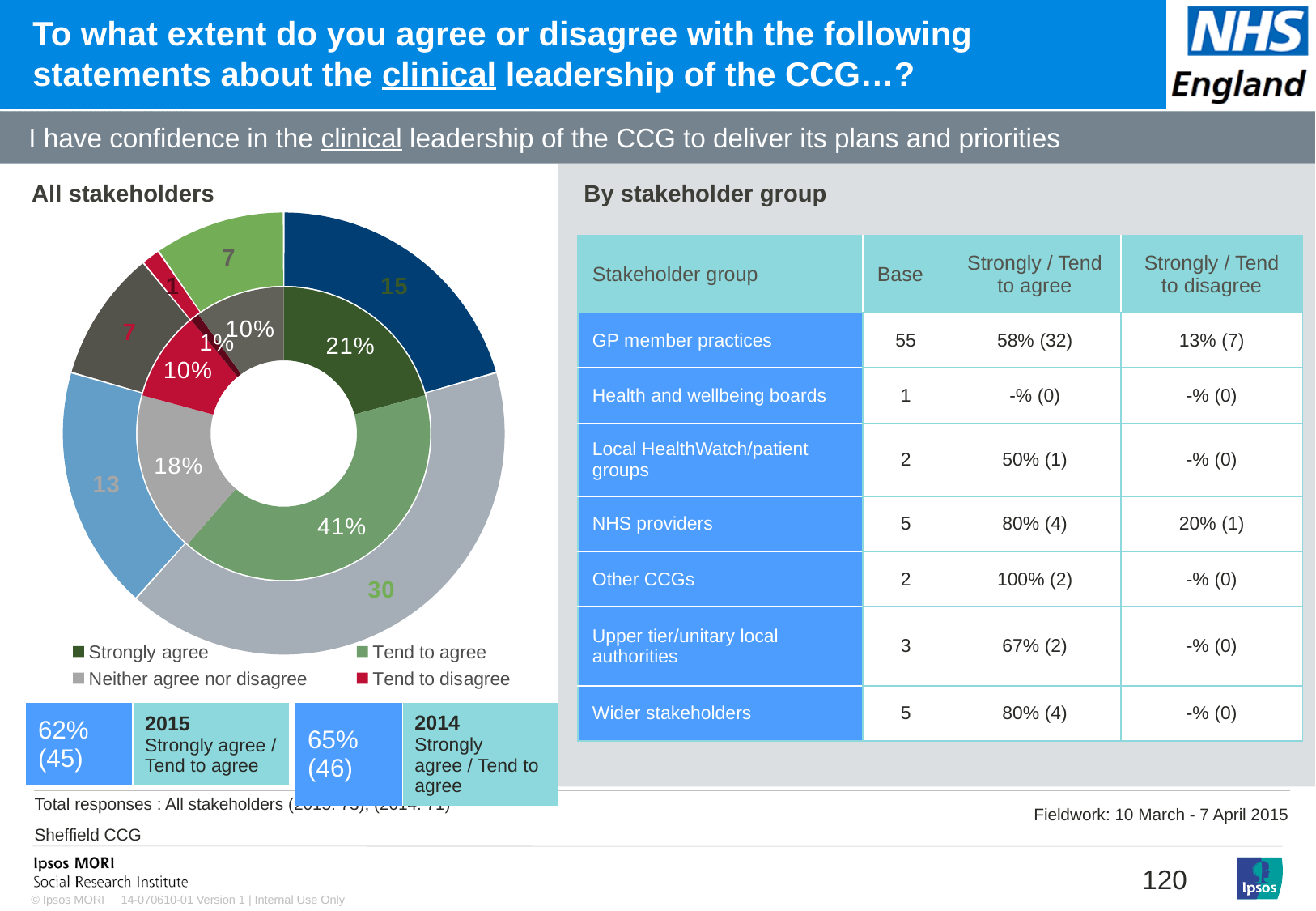
In the All stakeholders doughnut chart, what percentage is shown for Strongly agree? 21% How many entries does the legend of the All stakeholders chart list? 4 In the All stakeholders doughnut chart, what percentage is shown for Tend to agree? 41% What type of chart is used for the All stakeholders data? Doughnut chart In the All stakeholders doughnut chart, which legend category has the largest share? Tend to agree In the All stakeholders doughnut chart, what is the difference in percentage points between Tend to agree and Strongly agree? 20 percentage points In the All stakeholders doughnut chart, what percentage is shown for Neither agree nor disagree? 18% In the All stakeholders doughnut chart, what colour represents Tend to disagree? Red In the All stakeholders doughnut chart, what percentage is shown for Tend to disagree? 10% In the All stakeholders doughnut chart, which is larger: Neither agree nor disagree or Tend to disagree? Neither agree nor disagree In the All stakeholders doughnut chart, what count is shown on the outer ring for Strongly agree? 15 In the All stakeholders doughnut chart, what count is shown on the outer ring for Tend to agree? 30